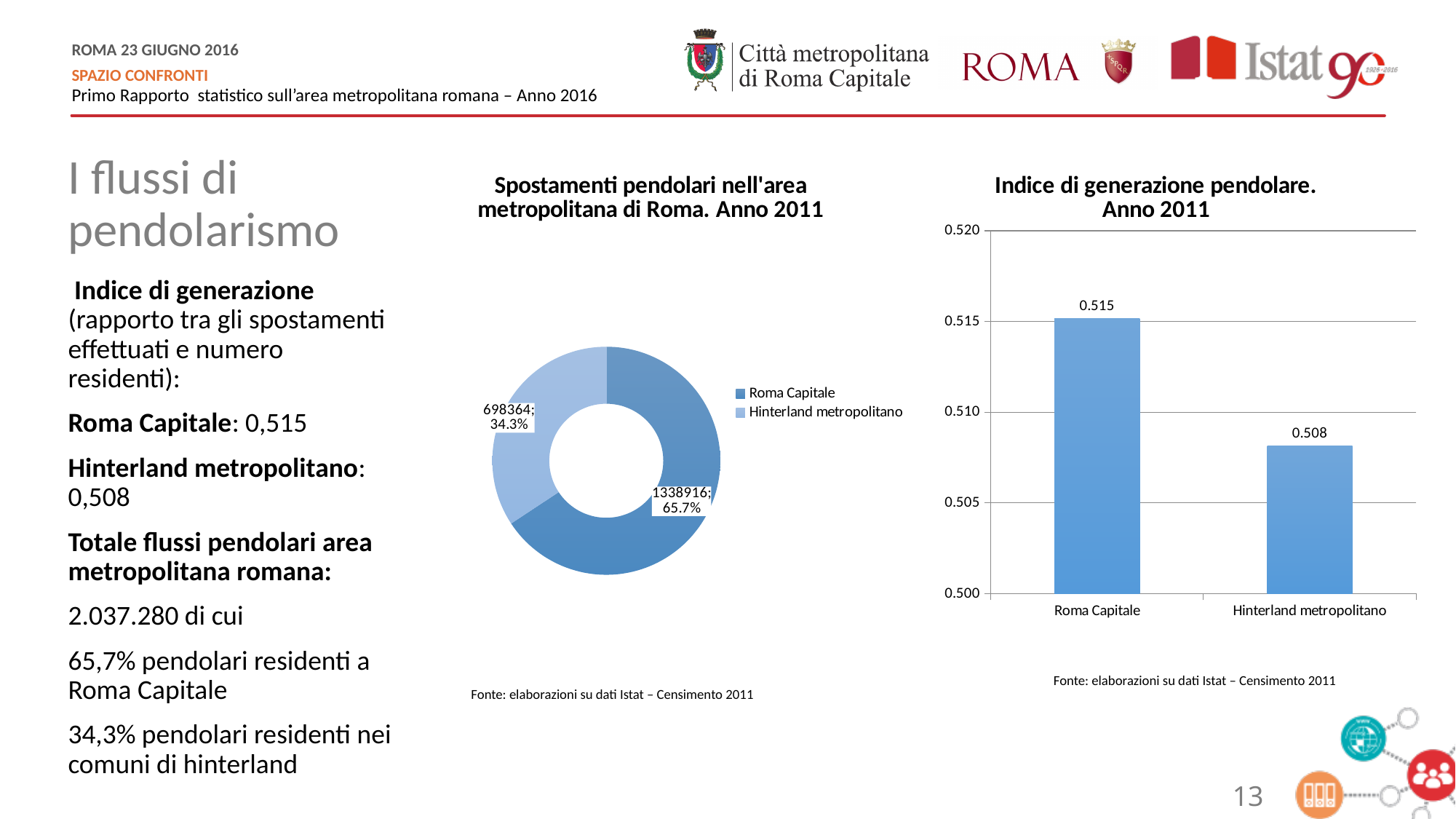
In the chart titled 'Indice di generazione pendolare. Anno 2011', which category has the lowest value? Hinterland metropolitano What kind of chart is the one titled 'Spostamenti pendolari nell'area metropolitana di Roma. Anno 2011'? Doughnut (pie) chart In the chart titled 'Indice di generazione pendolare. Anno 2011', what is the difference between the values for Roma Capitale and Hinterland metropolitano? 0.007 In the chart titled 'Spostamenti pendolari nell'area metropolitana di Roma. Anno 2011', what value is shown for Roma Capitale? 1338916 How many entries does the legend of the chart titled 'Spostamenti pendolari nell'area metropolitana di Roma. Anno 2011' list? 2 In the chart titled 'Spostamenti pendolari nell'area metropolitana di Roma. Anno 2011', what value is shown for Hinterland metropolitano? 698364 In the chart titled 'Spostamenti pendolari nell'area metropolitana di Roma. Anno 2011', what share of the total does Roma Capitale represent? 65.7% In the chart titled 'Indice di generazione pendolare. Anno 2011', what is the value for Roma Capitale? 0.515 What kind of chart is the one titled 'Indice di generazione pendolare. Anno 2011'? Bar chart In the chart titled 'Spostamenti pendolari nell'area metropolitana di Roma. Anno 2011', what share of the total does Hinterland metropolitano represent? 34.3% In the chart titled 'Indice di generazione pendolare. Anno 2011', what is the value for Hinterland metropolitano? 0.508 In the chart titled 'Spostamenti pendolari nell'area metropolitana di Roma. Anno 2011', which category has the larger slice? Roma Capitale